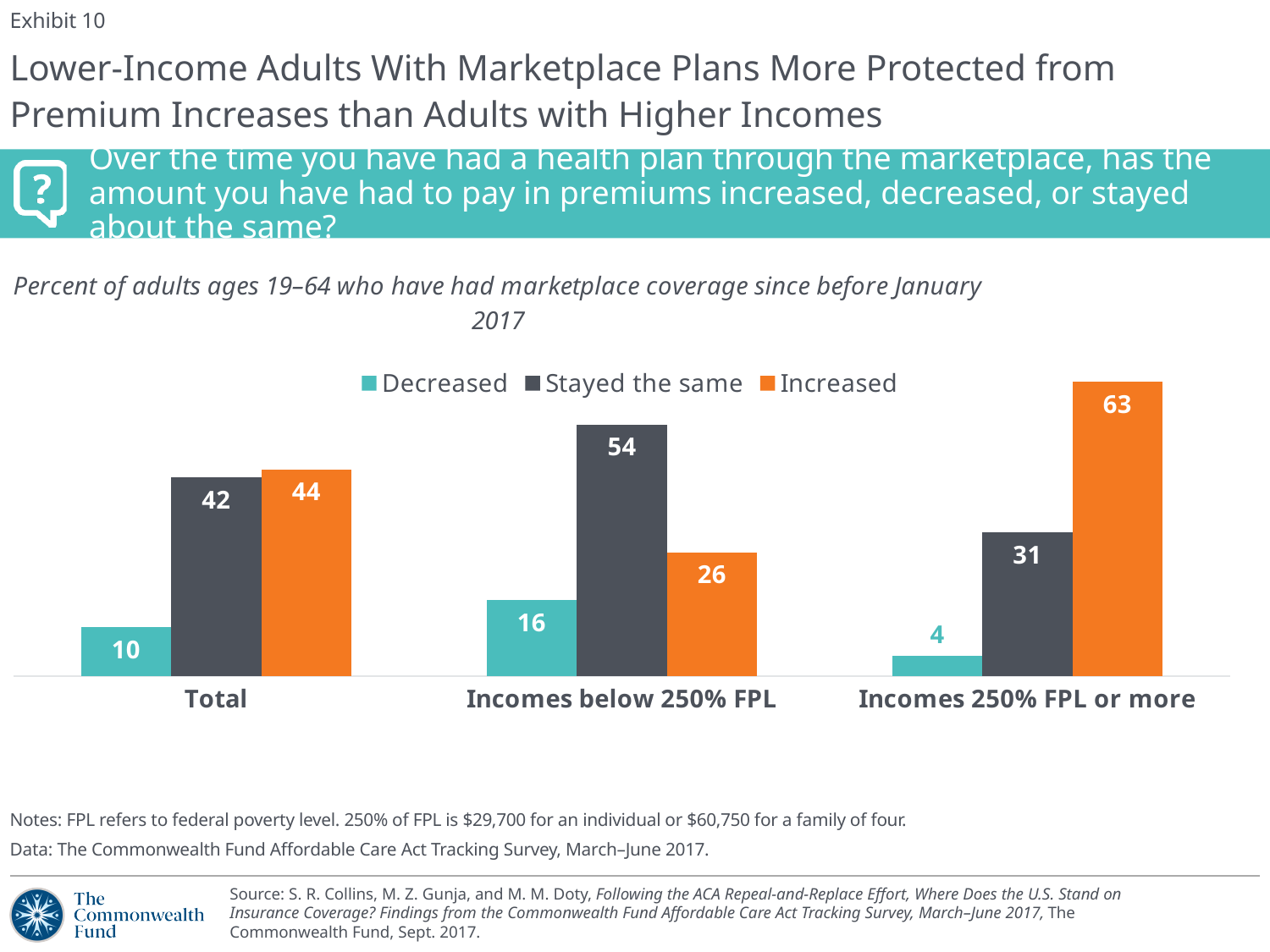
What is the value for "Stayed the same" in the "Incomes below 250% FPL" category? 54 What is the value for "Decreased" in the "Total" category? 10 How many categories are shown on the x axis? 3 Which colour represents the "Increased" series in the legend? Orange What is the difference between the "Increased" values for "Incomes 250% FPL or more" and "Incomes below 250% FPL"? 37 Which category has the lowest value for "Decreased"? Incomes 250% FPL or more Which is larger in the "Incomes below 250% FPL" category: "Stayed the same" or "Increased"? Stayed the same What is the value for "Increased" in the "Incomes 250% FPL or more" category? 63 What is the difference between the "Stayed the same" values for "Total" and "Incomes 250% FPL or more"? 11 What kind of chart is shown on the slide? Bar chart How many series does the legend list? 3 Which category has the highest value for "Increased"? Incomes 250% FPL or more